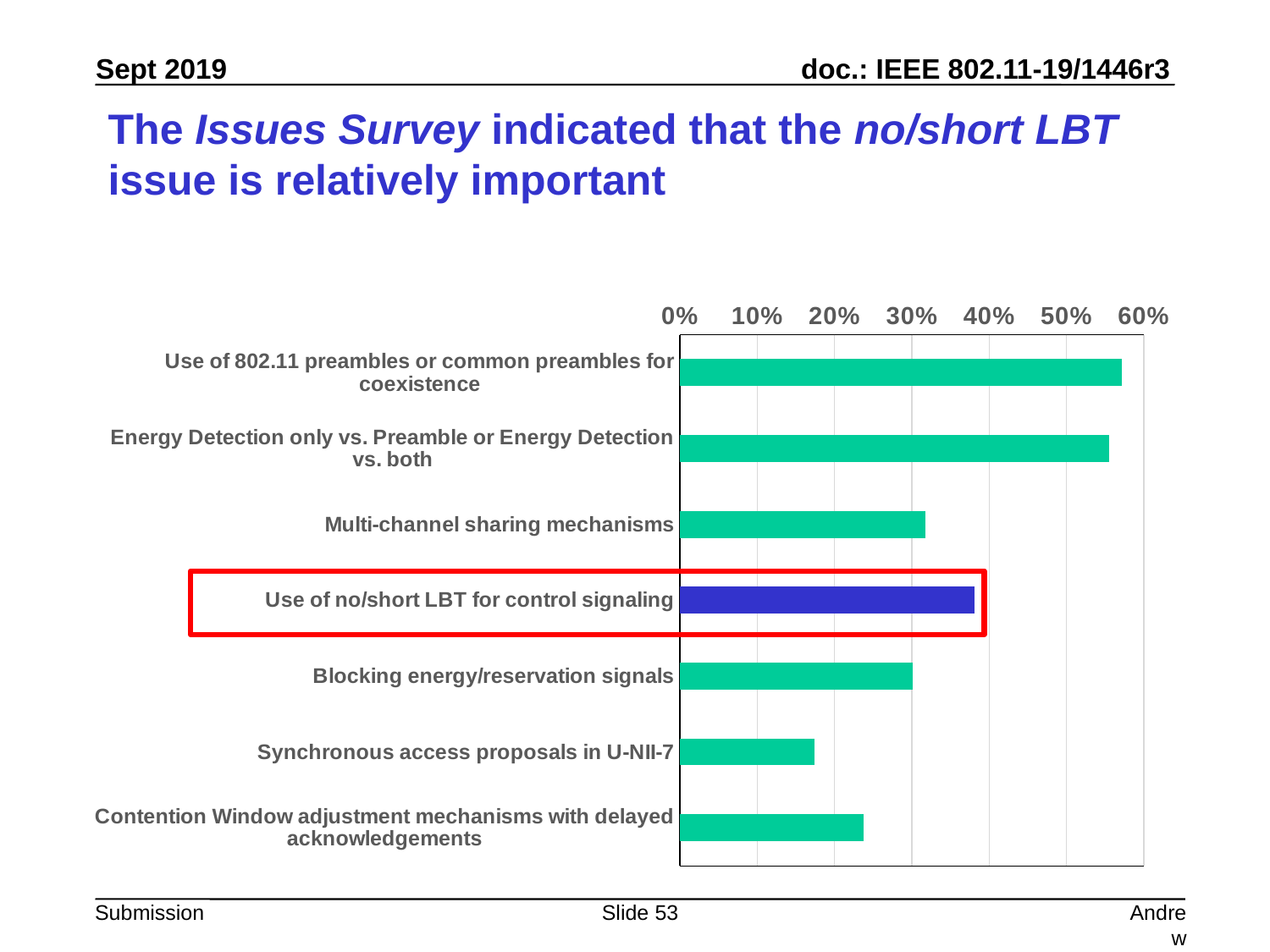
Which is larger: the value for Use of no/short LBT for control signaling or the value for Multi-channel sharing mechanisms? Use of no/short LBT for control signaling Which category's bar is drawn in a different colour (dark blue) and outlined with a red box? Use of no/short LBT for control signaling Which is larger: the value for Synchronous access proposals in U-NII-7 or the value for Contention Window adjustment mechanisms with delayed acknowledgements? Contention Window adjustment mechanisms with delayed acknowledgements Which category has the lowest value? Synchronous access proposals in U-NII-7 Is the value for Synchronous access proposals in U-NII-7 greater or less than 20%? less Is the value for Use of no/short LBT for control signaling greater or less than 40%? less How many categories (bars) does the chart show? 7 Is the value for Use of no/short LBT for control signaling greater or less than 30%? greater What is the highest value shown on the chart's percentage axis? 60% What kind of chart is shown on the slide? bar chart